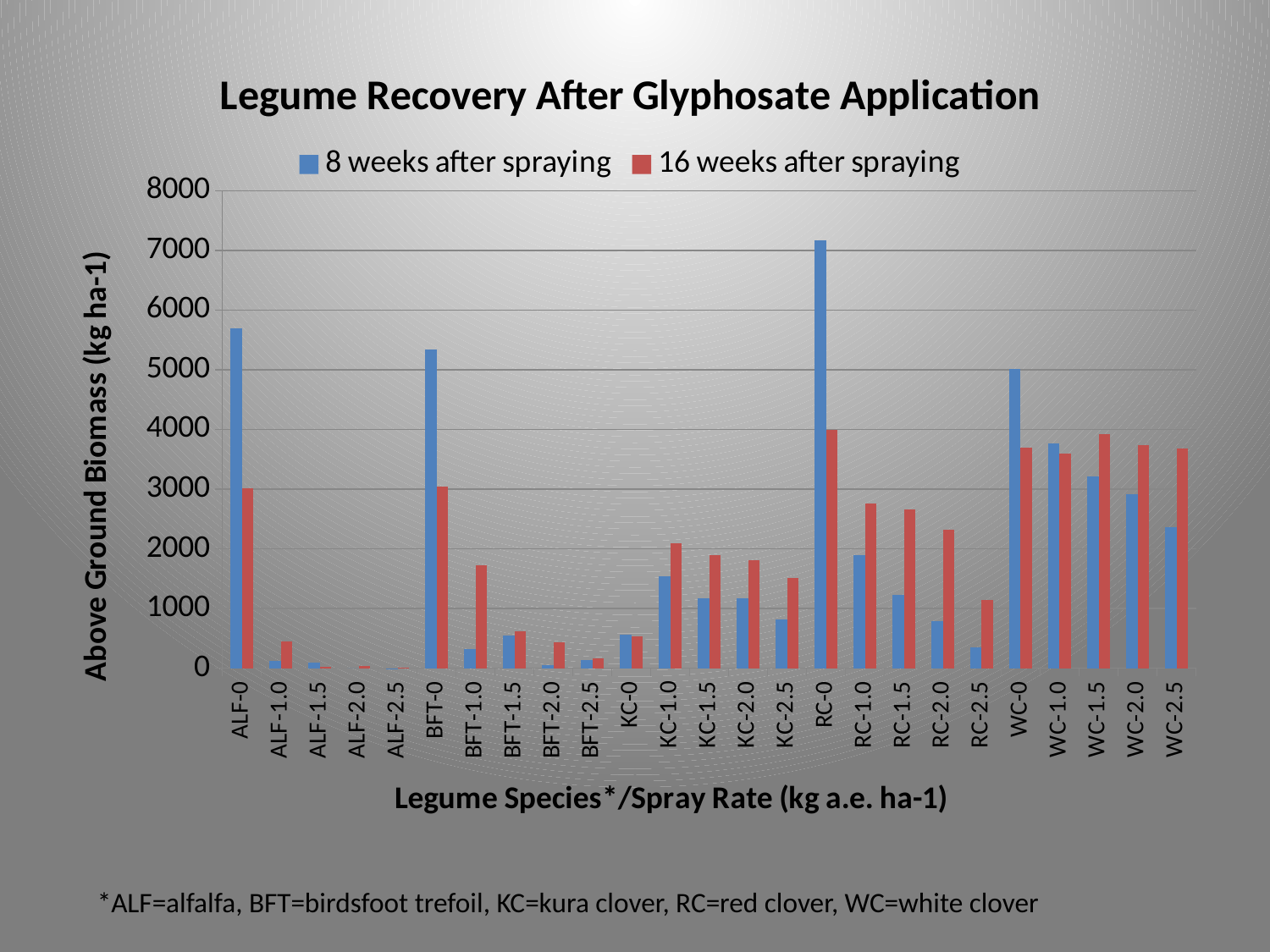
Is the 8 weeks after spraying value for ALF-0 greater or less than 5000? greater Is the 8 weeks after spraying value for KC-0 greater or less than 1000? less Which category has the highest value for the 8 weeks after spraying series? RC-0 How many species/spray-rate categories are shown on the x axis? 25 For KC-1.0, which series has the larger value: 8 weeks after spraying or 16 weeks after spraying? 16 weeks after spraying For ALF-0, which series has the larger value: 8 weeks after spraying or 16 weeks after spraying? 8 weeks after spraying How many series does the legend list? 2 Is the 16 weeks after spraying value for WC-2.5 greater or less than 3000? greater Do the 8 weeks after spraying values for alfalfa (ALF) rise or fall as the spray rate increases from ALF-0 to ALF-2.5? fall What kind of chart is shown on the slide? bar chart What is the title of the chart? Legume Recovery After Glyphosate Application